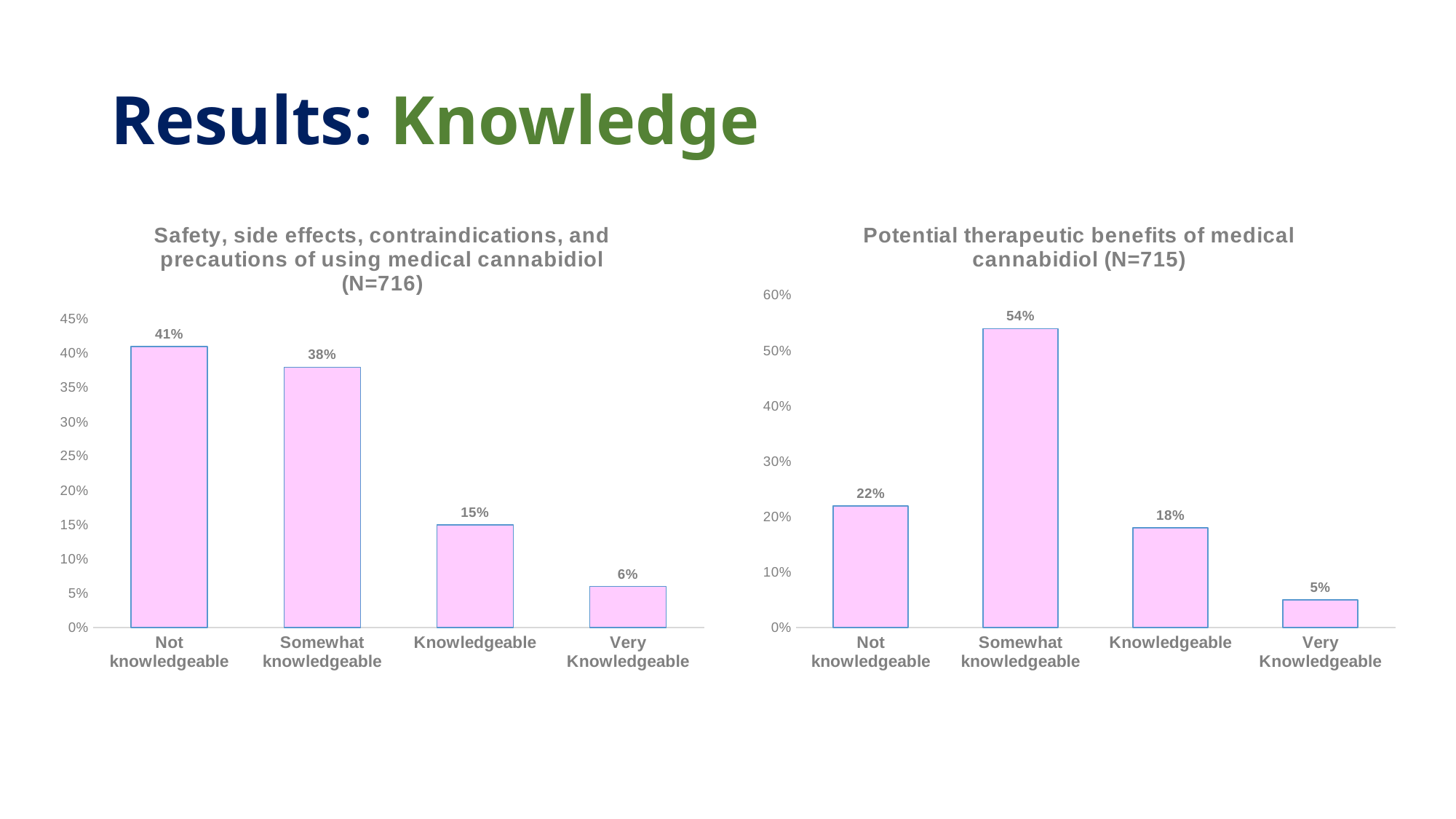
In the left chart (Safety, side effects, contraindications, and precautions), which category has the highest value? Not knowledgeable How many categories are shown in the left chart (Safety, side effects, contraindications, and precautions)? 4 In the left chart (Safety, side effects, contraindications, and precautions), what is the value for Not knowledgeable? 41% In the left chart (Safety, side effects, contraindications, and precautions), what is the value for Very Knowledgeable? 6% In the right chart (Potential therapeutic benefits), what is the value for Knowledgeable? 18% In the left chart (Safety, side effects, contraindications, and precautions), what is the difference between Not knowledgeable and Somewhat knowledgeable? 3% In the right chart (Potential therapeutic benefits), what is the difference between Somewhat knowledgeable and Not knowledgeable? 32% What is the sample size (N) given in the title of the right chart (Potential therapeutic benefits)? N=715 In the right chart (Potential therapeutic benefits), what is the value for Somewhat knowledgeable? 54% In the right chart (Potential therapeutic benefits), which is larger: Not knowledgeable or Knowledgeable? Not knowledgeable In the right chart (Potential therapeutic benefits), which category has the lowest value? Very Knowledgeable What kind of chart is the right chart (Potential therapeutic benefits)? Bar chart